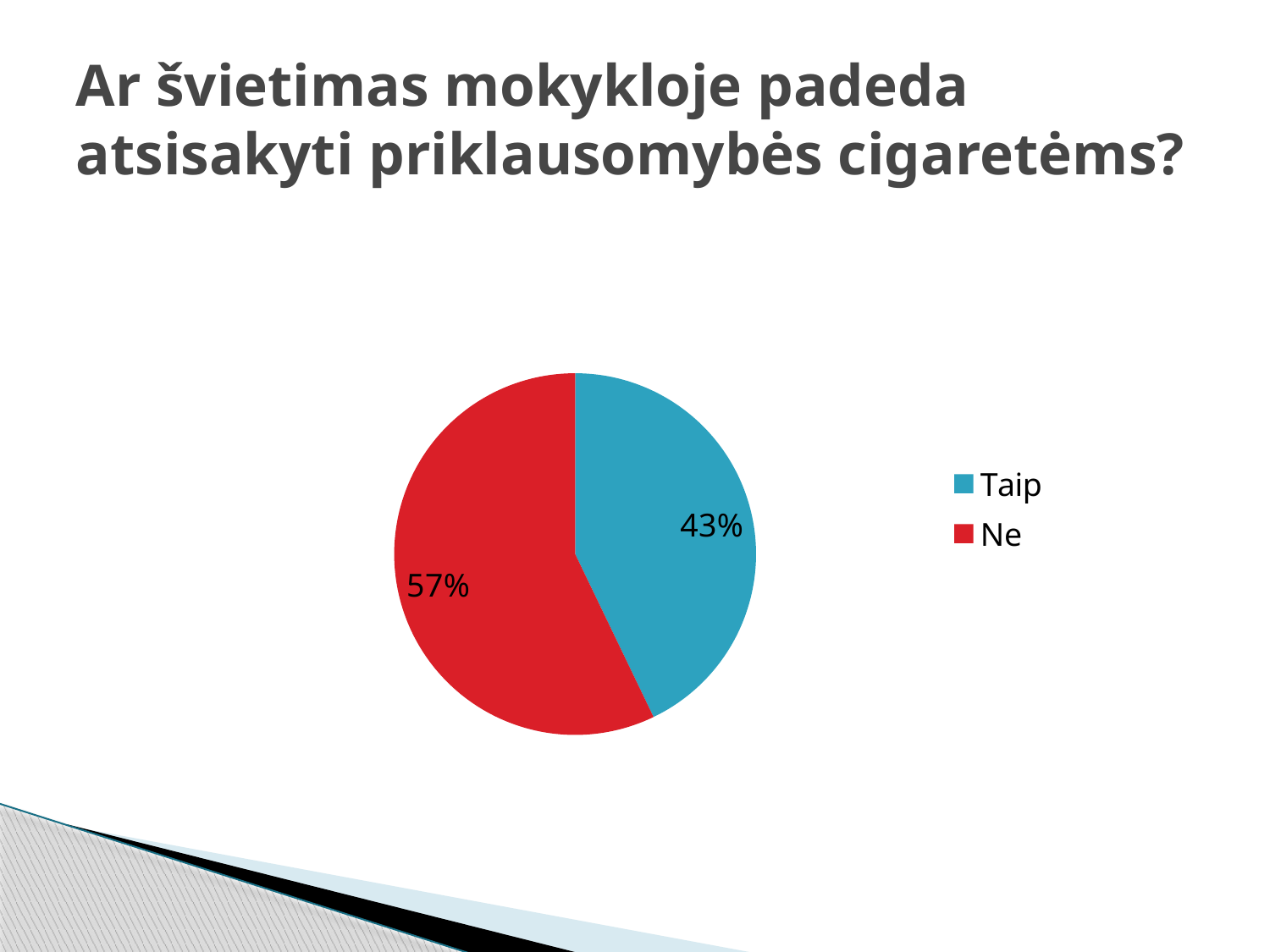
What colour is the "Taip" slice in the pie chart? Blue Which category has the smallest share of the pie chart? Taip What type of chart is shown on the slide? Pie chart Which category has the largest share of the pie chart? Ne What percentage of the pie chart is labelled "Taip"? 43% How many entries does the legend list? 2 What share of the pie does the "Ne" slice represent? 57% What is the difference in percentage points between the "Ne" and "Taip" slices? 14 What colour is the "Ne" slice in the pie chart? Red How many slices does the pie chart have? 2 What percentage of the pie chart is labelled "Ne"? 57% Which slice is larger, "Taip" or "Ne"? Ne